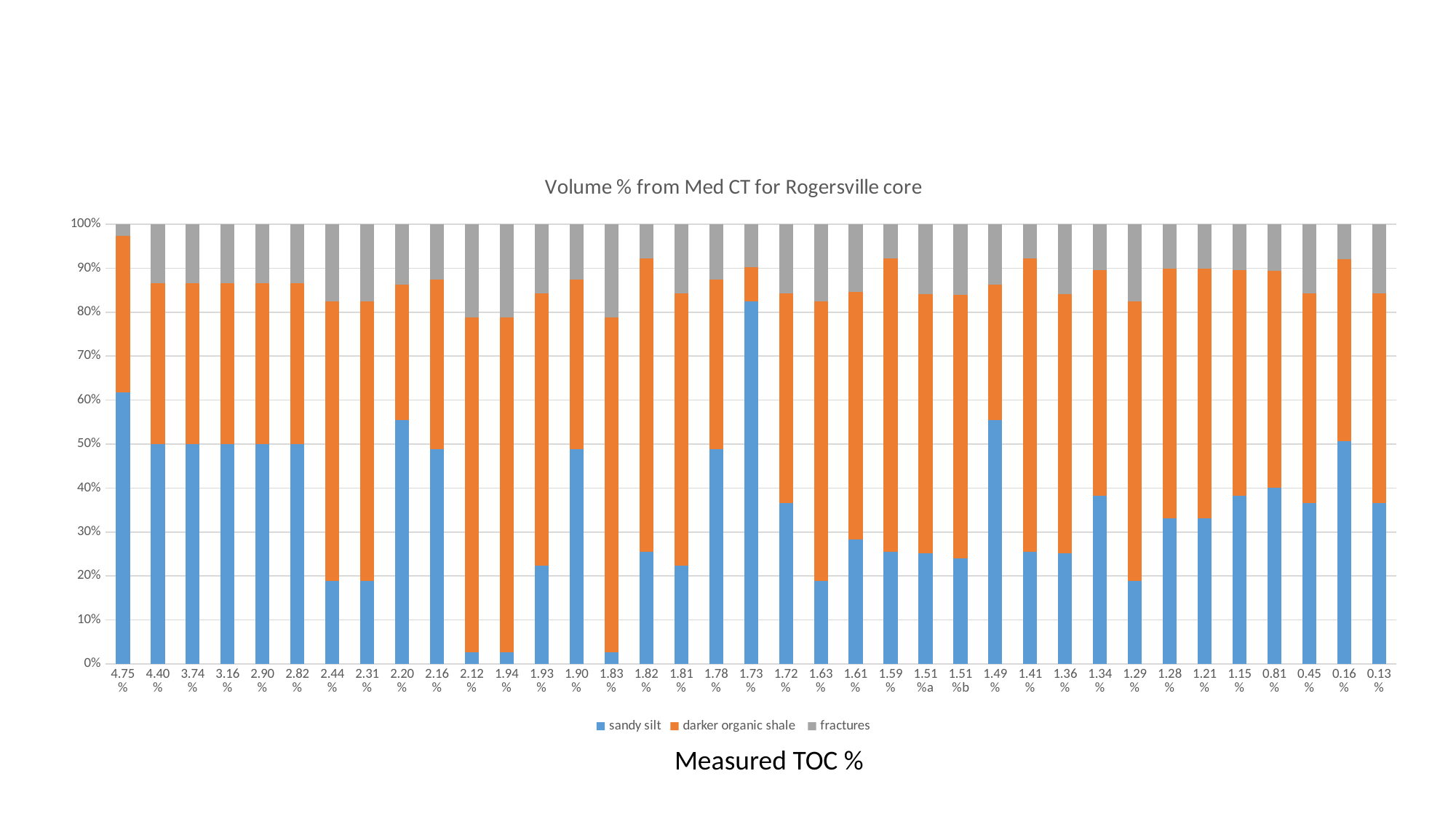
Which category has the smallest fractures share? 4.75% What is the total height of each stacked bar in the chart? 100% What is the title of the chart? Volume % from Med CT for Rogersville core What kind of chart is shown on the slide? stacked bar chart Is the sandy silt value for the 2.12% category greater or less than 10%? less How many bars (measured TOC categories) are plotted in the chart? 37 Is the sandy silt value for the 4.75% category greater or less than 50%? greater Is the sandy silt value for the 1.73% category greater or less than 70%? greater How many series does the legend list? 3 Which category has the highest sandy silt share? 1.73% Which category has a larger sandy silt share, 4.40% or 2.44%? 4.40% Which series are listed in the legend? sandy silt, darker organic shale, fractures